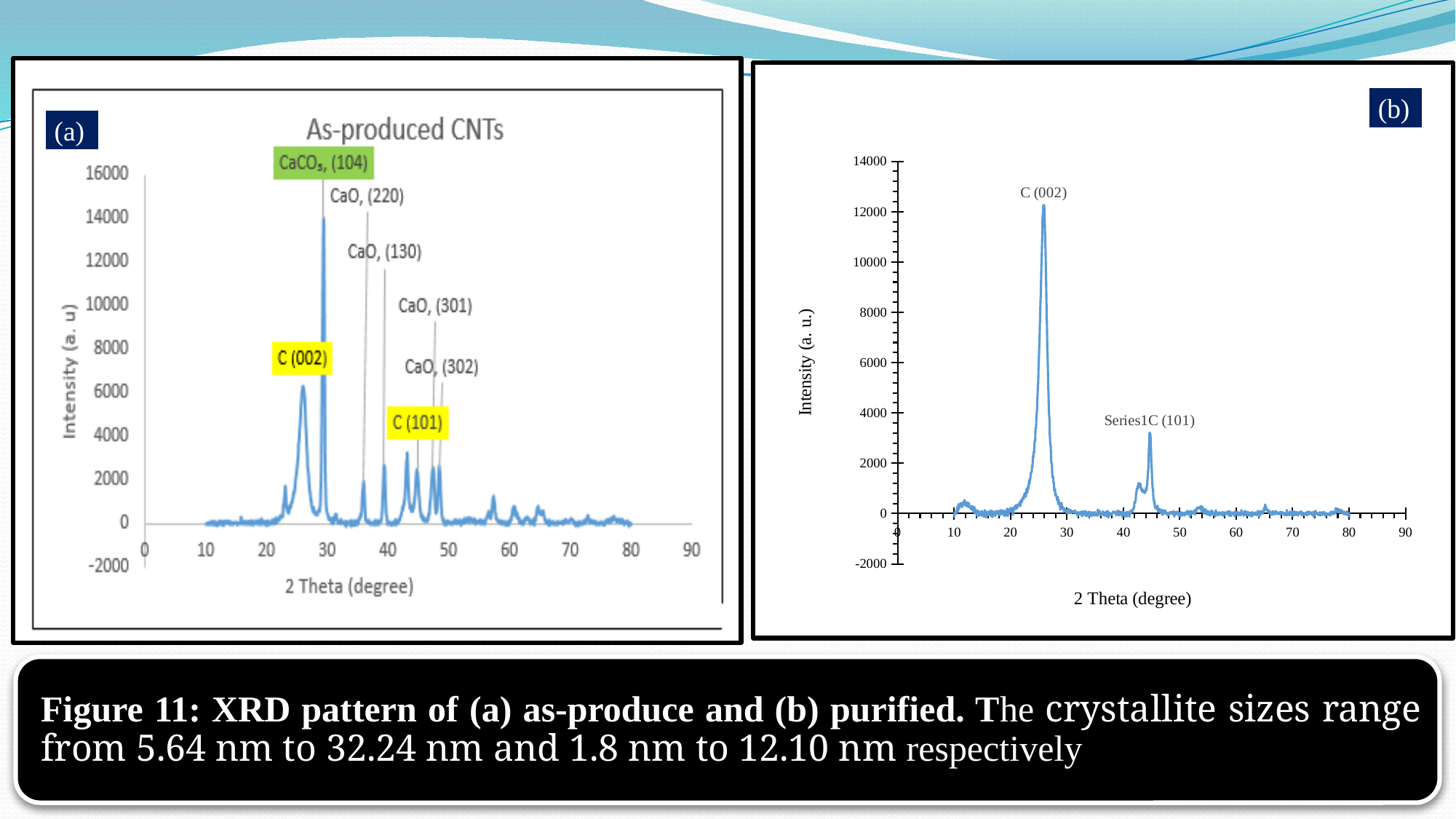
What is the y-axis label of chart (b) on the right? Intensity (a. u.) How many labeled peaks are there in chart (b) on the right? 2 In chart (a), As-produced CNTs, is the intensity of the C (002) peak greater or less than 8000? less In chart (a), As-produced CNTs, is the intensity of the CaCO3 (104) peak greater or less than 12000? greater In chart (a), As-produced CNTs, which labeled peak has the highest intensity? CaCO3, (104) In chart (b) on the right, is the intensity of the C (002) peak greater or less than 10000? greater In chart (b) on the right, which labeled peak is higher, C (002) or C (101)? C (002) How many labeled peaks are there in chart (a), As-produced CNTs? 7 What kind of chart is chart (a), titled As-produced CNTs? line chart What is the title of chart (a) on the left? As-produced CNTs In chart (a), As-produced CNTs, which peak is higher, C (002) or C (101)? C (002)